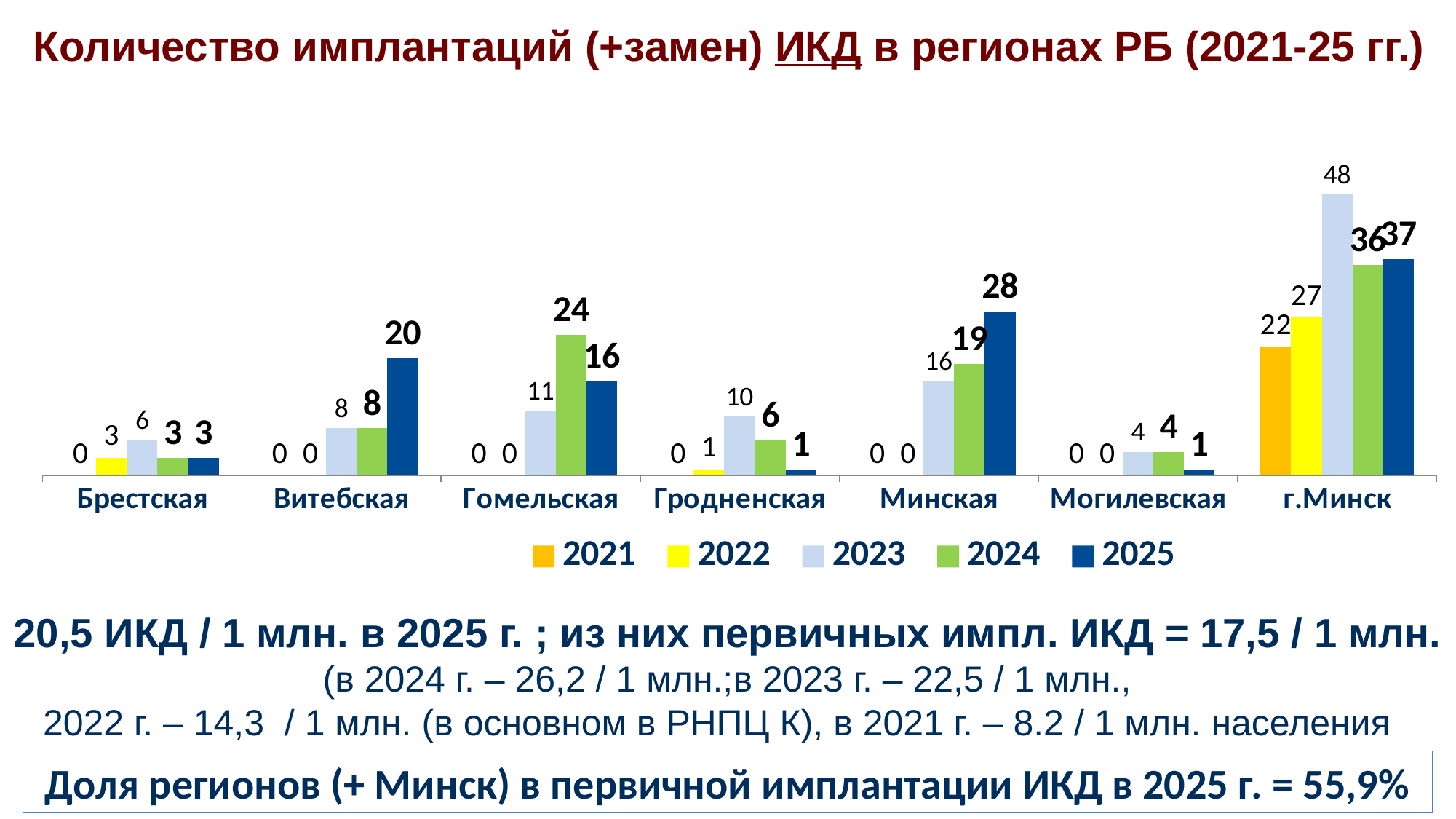
What is the difference between the 2025 and 2024 values for Витебская? 12 What is the value for Минская in 2025? 28 Which region has the highest value in 2025? г.Минск How many series does the legend list? 5 What is the value for г.Минск in 2023? 48 Which region has the lowest value in 2025? Гродненская and Могилевская (1 each) Do the values for Минская rise or fall from 2023 to 2025? rise What is the value for Гомельская in 2024? 24 Which colour represents the 2021 series in the legend? orange Which is larger for Гомельская: the 2024 value or the 2025 value? 2024 How many regions (categories) are shown on the x axis? 7 What type of chart is shown on the slide? bar chart